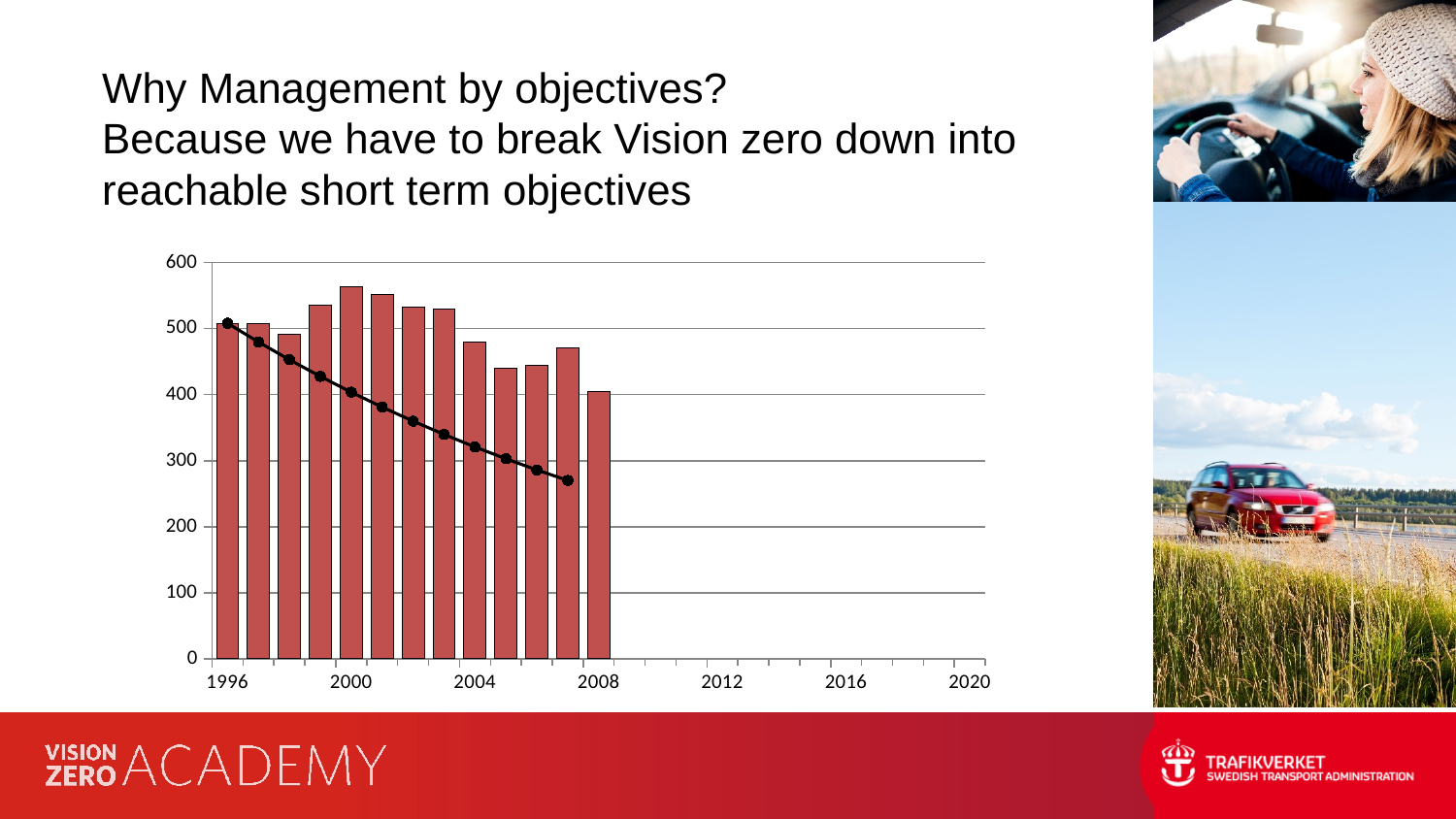
Is the bar for 2005 greater or less than 500? less What is the first year shown on the x axis? 1996 Does the black line rise or fall from 1996 to 2007? falls Is the bar for 2008 greater or less than 500? less Is the last point of the black line (at 2007) greater or less than 300? less How many bars are plotted in the chart? 13 Which bar is taller, 2000 or 2008? 2000 What is the highest value labelled on the y axis? 600 What kind of chart is shown on the slide? Bar chart with a line overlay Which year has the tallest bar in the chart? 2000 Which year has the shortest bar in the chart? 2008